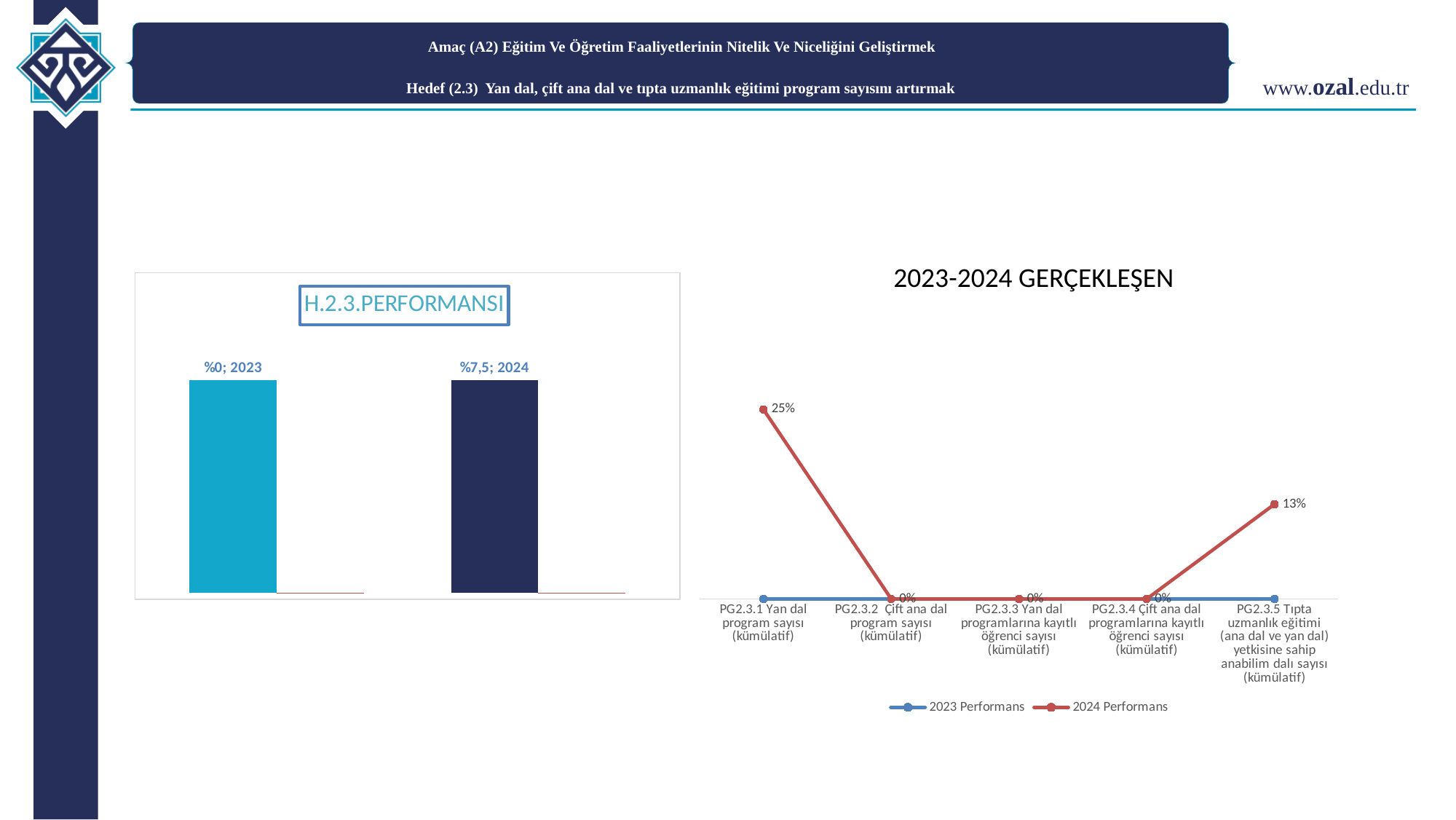
What kind of chart is the 2023-2024 GERÇEKLEŞEN chart on the right? line chart What are the two legend entries in the 2023-2024 GERÇEKLEŞEN chart? 2023 Performans and 2024 Performans In the 2023-2024 GERÇEKLEŞEN chart, what is the difference between the 2024 Performans values for PG2.3.1 and PG2.3.5? 12% How many categories are shown on the x axis of the 2023-2024 GERÇEKLEŞEN chart? 5 In the 2023-2024 GERÇEKLEŞEN chart, what is the 2024 Performans value for PG2.3.1 Yan dal program sayısı (kümülatif)? 25% In the H.2.3.PERFORMANSI chart, what value is shown for 2024? %7,5 In the 2023-2024 GERÇEKLEŞEN chart, what is the 2024 Performans value for PG2.3.5 Tıpta uzmanlık eğitimi (ana dal ve yan dal) yetkisine sahip anabilim dalı sayısı (kümülatif)? 13% In the H.2.3.PERFORMANSI chart, what value is shown for 2023? %0 In the 2023-2024 GERÇEKLEŞEN chart, which category has the highest 2024 Performans value? PG2.3.1 Yan dal program sayısı (kümülatif) What kind of chart is the H.2.3.PERFORMANSI chart on the left? bar chart How many series does the legend of the 2023-2024 GERÇEKLEŞEN chart list? 2 How many bars are in the H.2.3.PERFORMANSI chart? 2